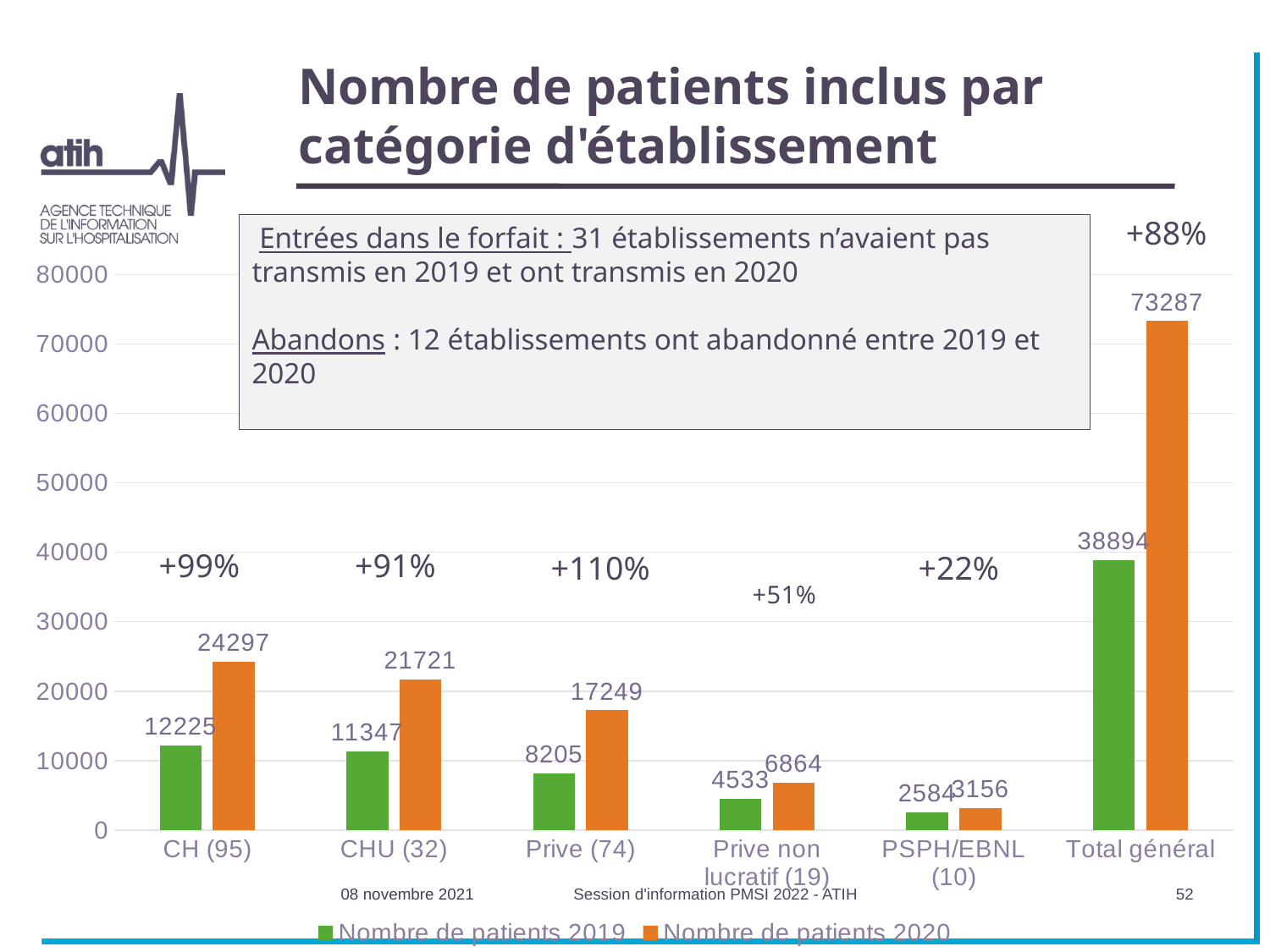
What is the value of Nombre de patients 2020 for Prive (74)? 17249 What is the value of Nombre de patients 2020 for CH (95)? 24297 Which category has the lowest value for Nombre de patients 2019? PSPH/EBNL (10) Which is larger: Nombre de patients 2019 for CH (95) or Nombre de patients 2019 for CHU (32)? CH (95) What type of chart is shown on the slide? bar chart What colour represents Nombre de patients 2020 in the legend? orange How many categories are shown on the x axis? 6 Excluding Total général, which category has the highest value for Nombre de patients 2020? CH (95) What is the value of Nombre de patients 2019 for CHU (32)? 11347 What percentage change is labelled above the Total général bars? +88% How many series does the legend list? 2 What is the difference between Nombre de patients 2020 and Nombre de patients 2019 for Prive non lucratif (19)? 2331